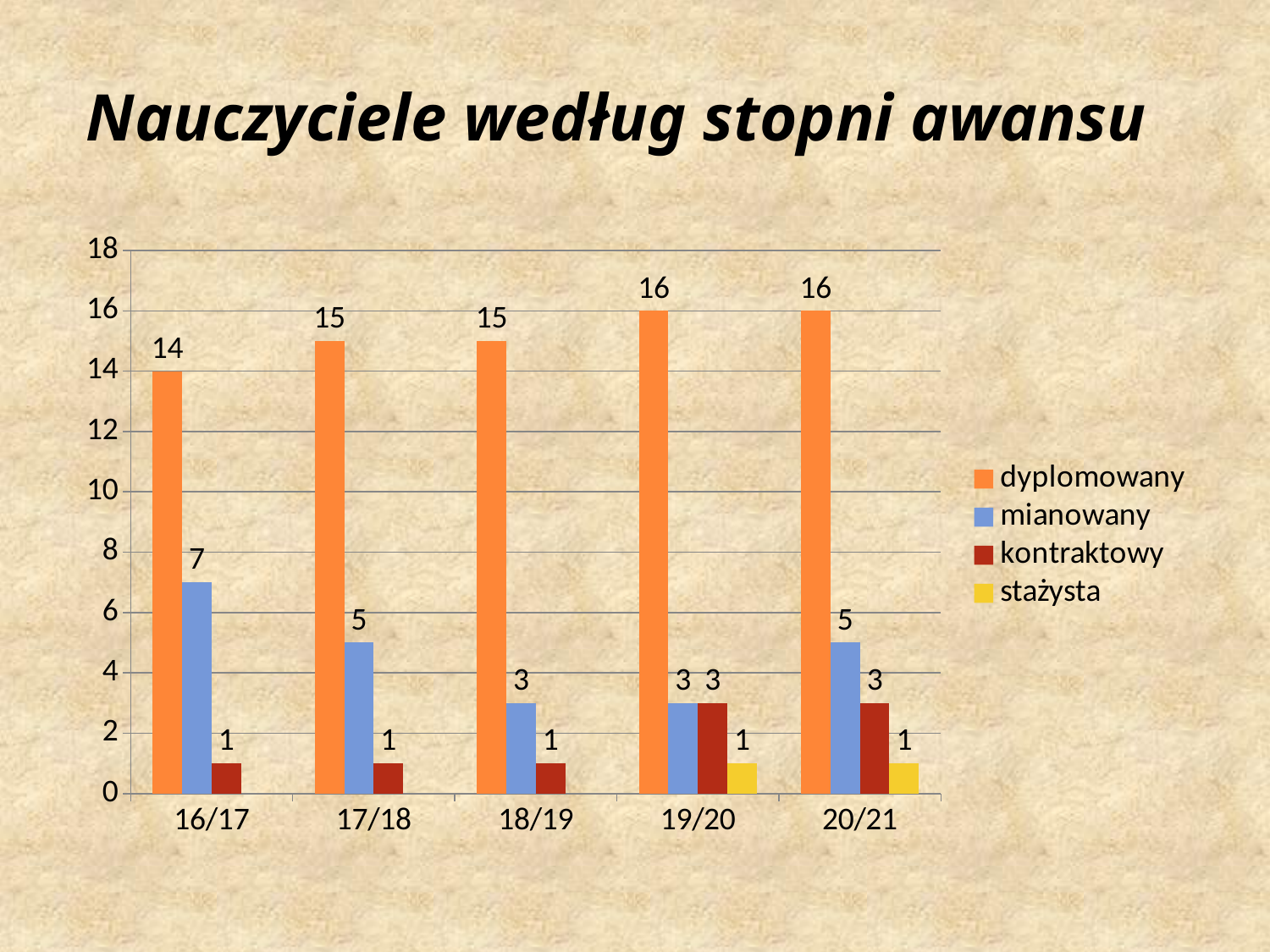
In which year is the mianowany value highest? 16/17 What is the value for stażysta in 20/21? 1 What is the value for dyplomowany in 16/17? 14 What is the value for kontraktowy in 19/20? 3 What is the title of the slide? Nauczyciele według stopni awansu Which is larger in 18/19: mianowany or kontraktowy? mianowany What is the difference between the dyplomowany values in 20/21 and 16/17? 2 What is the value for mianowany in 17/18? 5 What kind of chart is shown on the slide? bar chart How many series does the legend list? 4 How many year categories are shown on the x axis? 5 In which year is the dyplomowany value lowest? 16/17